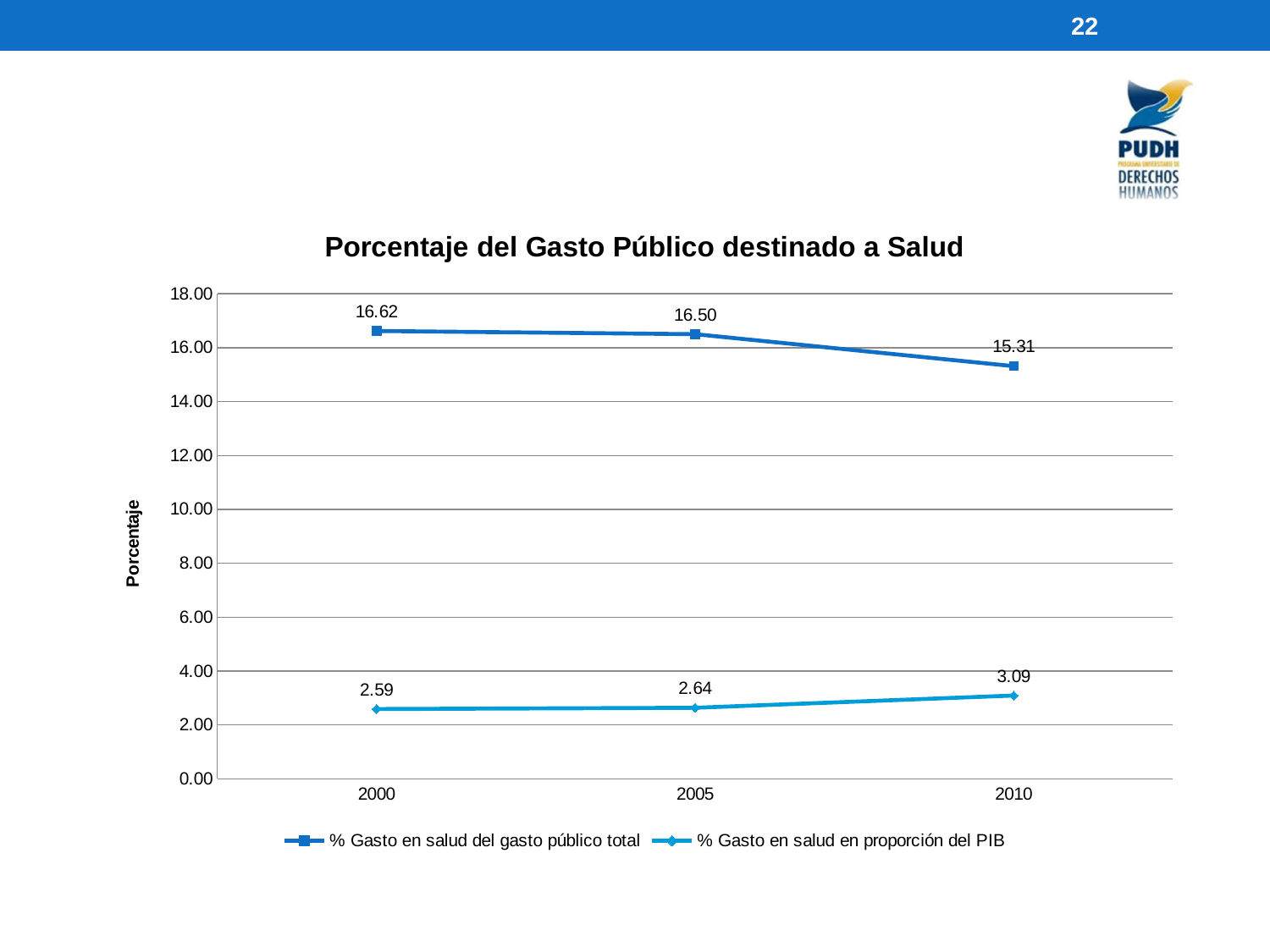
What kind of chart is shown? line chart In which year is "% Gasto en salud en proporción del PIB" highest? 2010 How many series does the legend list? 2 What is the value of "% Gasto en salud del gasto público total" in 2005? 16.50 What is the value of "% Gasto en salud del gasto público total" in 2000? 16.62 Which is larger: "% Gasto en salud en proporción del PIB" in 2005 or in 2010? 2010 Is the value of "% Gasto en salud del gasto público total" in 2010 greater or less than 16.00? less What is the difference between the 2000 and 2010 values of "% Gasto en salud del gasto público total"? 1.31 What is the value of "% Gasto en salud en proporción del PIB" in 2010? 3.09 How many years are plotted on the x axis? 3 In which year is "% Gasto en salud del gasto público total" lowest? 2010 Does "% Gasto en salud del gasto público total" rise or fall from 2000 to 2010? fall